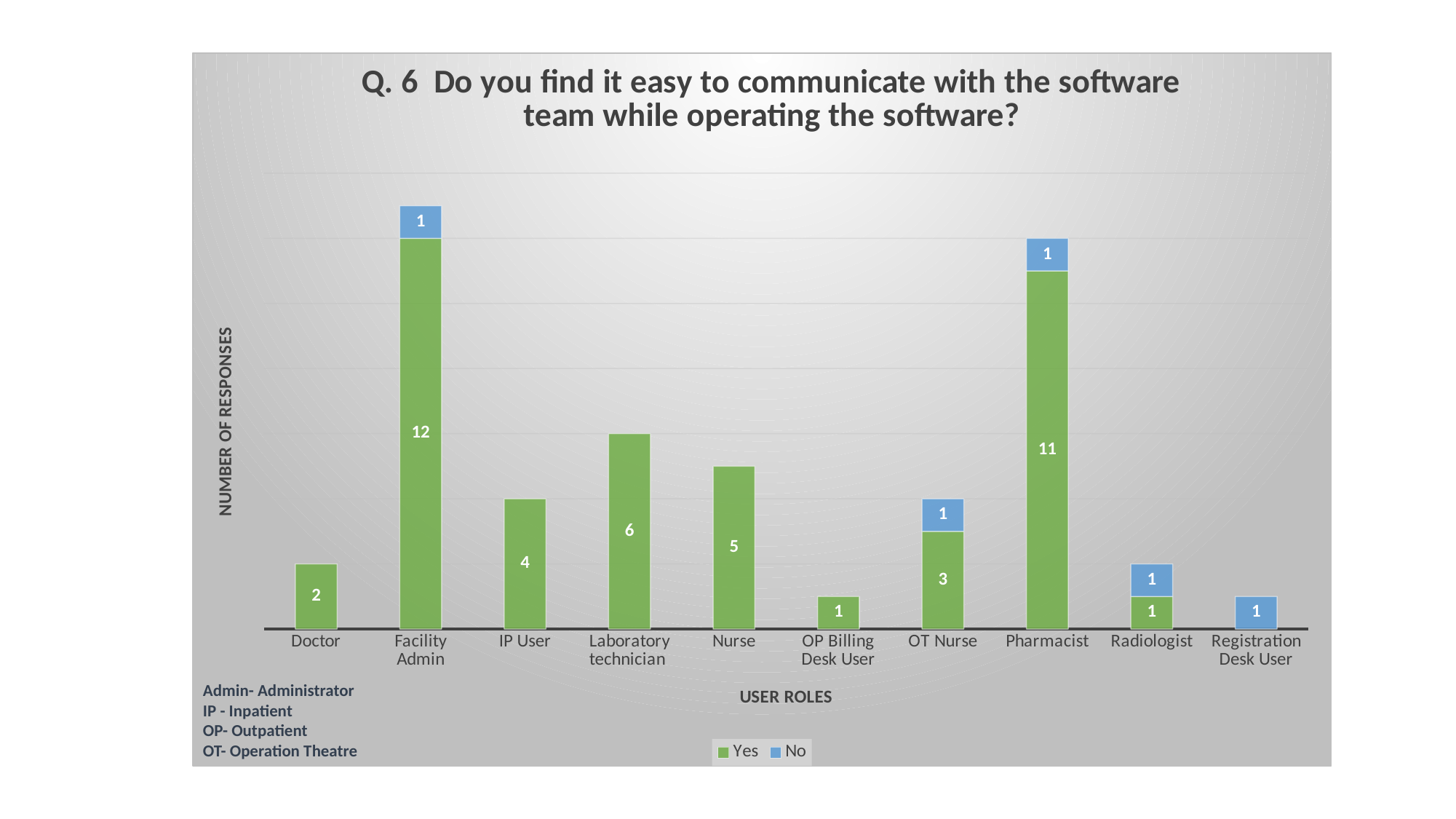
What colour represents the 'No' responses in the chart? Blue What is the difference between the 'Yes' responses for Facility Admin and Pharmacist? 1 How many 'Yes' responses did Facility Admin give? 12 What kind of chart is shown on the slide? Stacked bar chart What is the total number of responses for OT Nurse? 4 How many series does the legend list? 2 How many 'Yes' responses did Laboratory technician give? 6 How many 'No' responses did Pharmacist give? 1 What is the total number of responses for Pharmacist? 12 Which has more 'Yes' responses, Nurse or IP User? Nurse How many user roles are shown on the x axis? 10 Which user role has the highest number of 'Yes' responses? Facility Admin